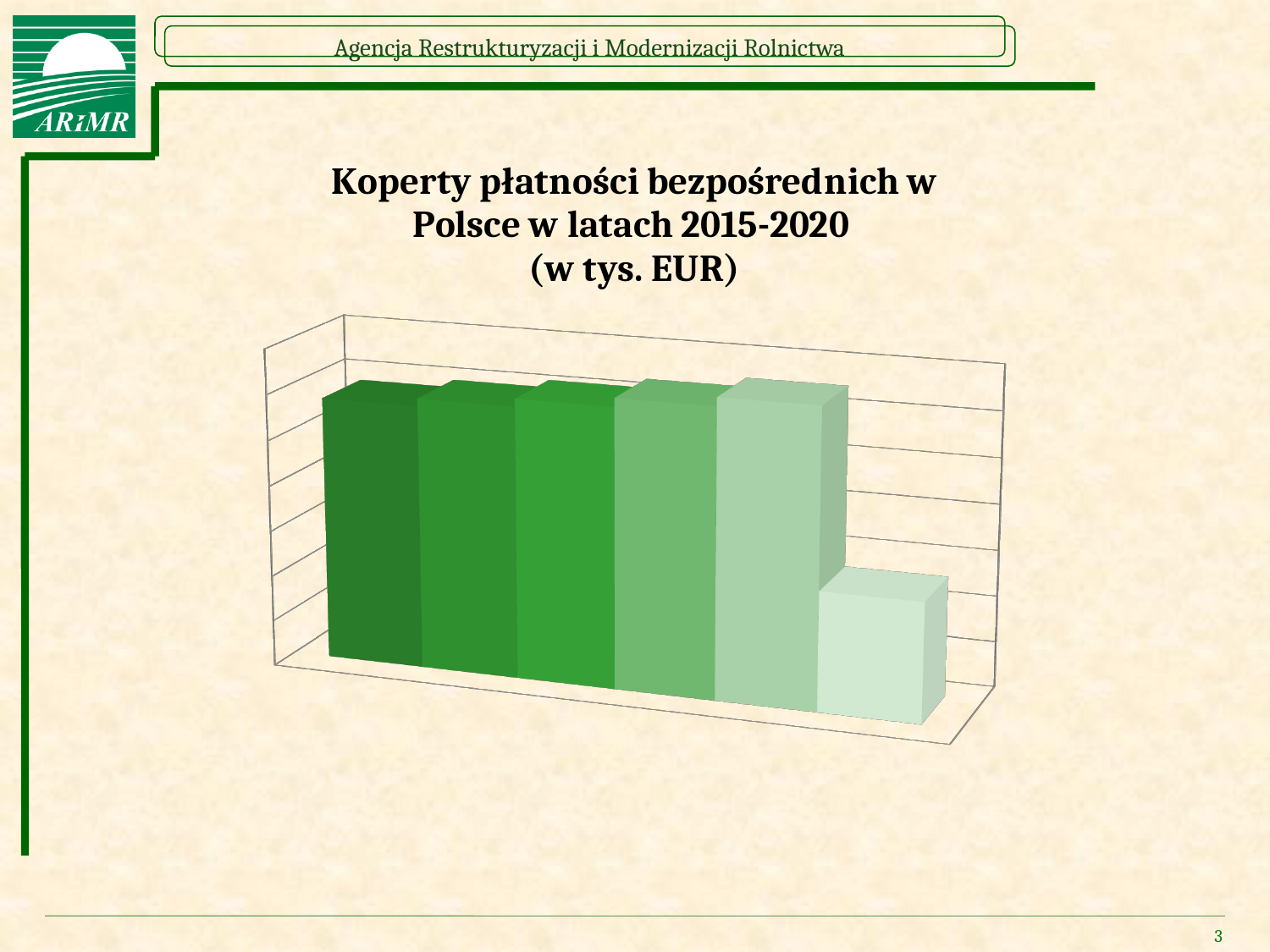
How many bars does the chart contain? 6 What kind of chart is shown on the slide? bar chart What is the title of the chart on the slide? Koperty płatności bezpośrednich w Polsce w latach 2015-2020 (w tys. EUR) Is the rightmost bar taller or shorter than the leftmost bar? shorter Which bar in the chart is the lowest? the rightmost (sixth) bar Does the chart show a legend? no In what unit are the values in the chart expressed, according to the title? tys. EUR